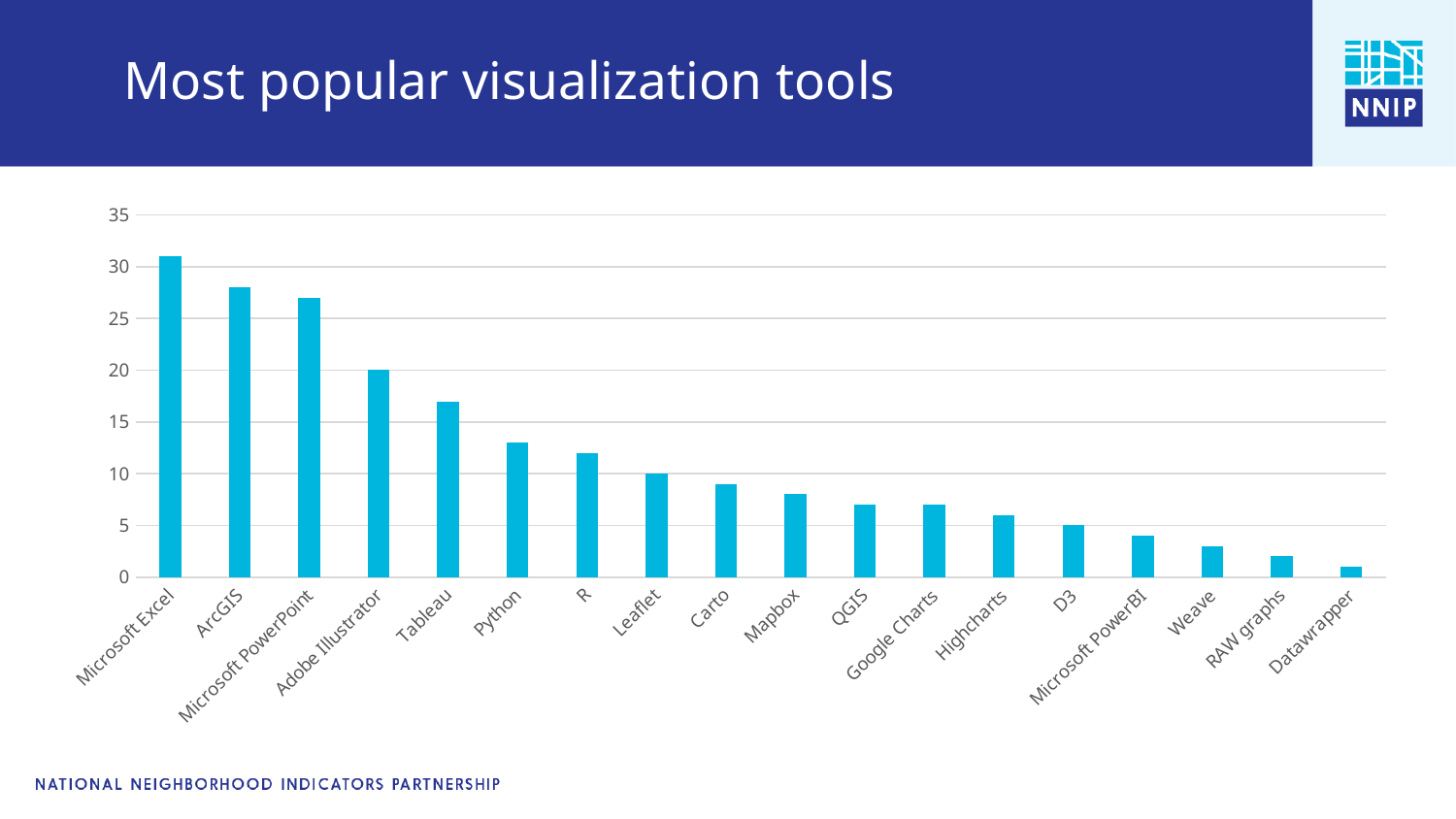
Do the values rise or fall moving from left to right along the x axis? fall What is the value for Leaflet? 10 What is the value for Adobe Illustrator? 20 What is the value for D3? 5 What kind of chart is shown on the slide? bar chart What is the title of the chart on the slide? Most popular visualization tools Is the value for Python greater or less than 15? less Is the value for Microsoft Excel greater or less than 30? greater How many visualization tools are shown on the x axis? 18 Which visualization tool has the lowest value? Datawrapper Which visualization tool has the highest value? Microsoft Excel Which has a larger value, ArcGIS or Tableau? ArcGIS